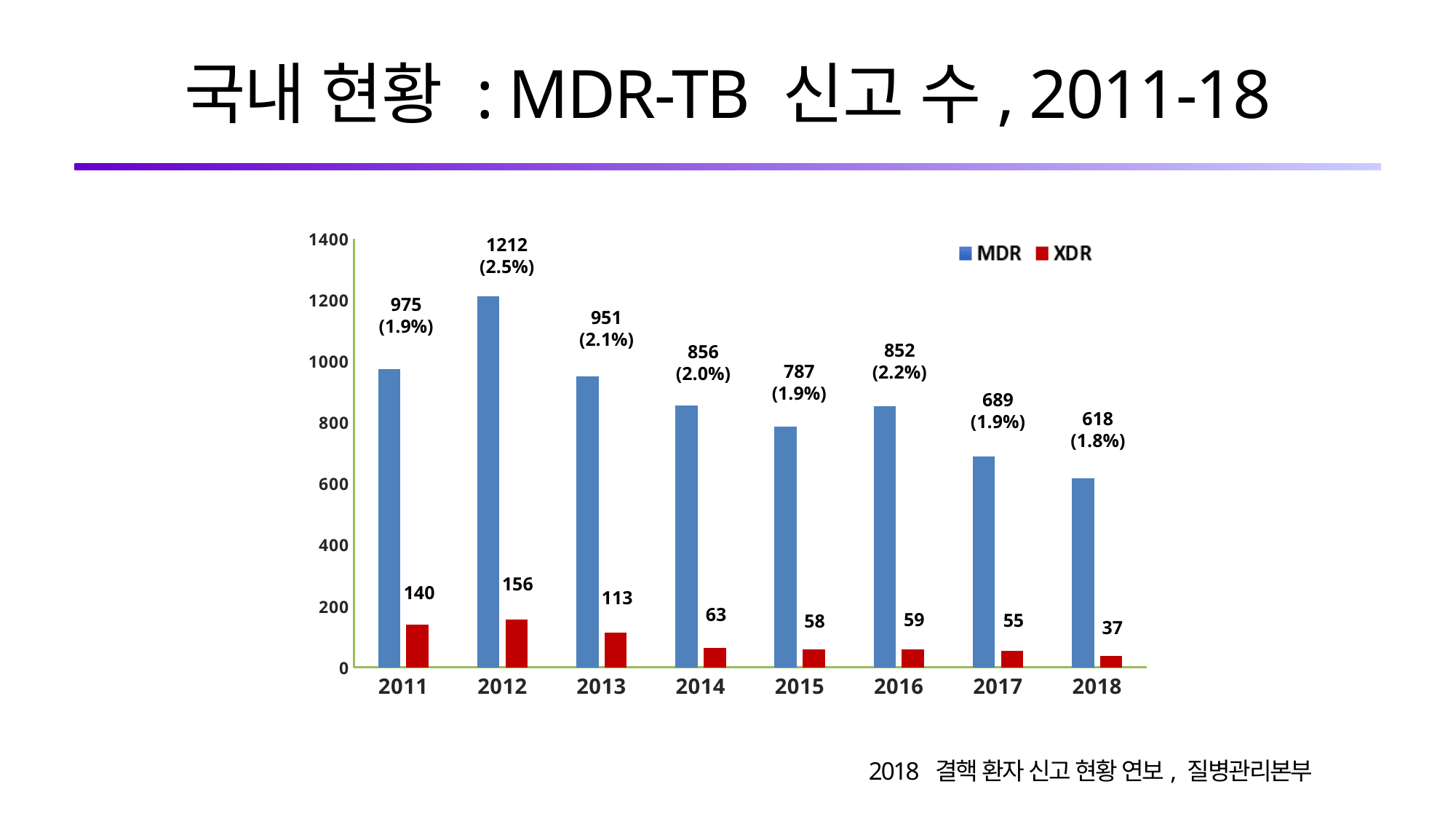
What kind of chart is shown on the slide? bar chart How many series does the legend list? 2 How many years are shown on the x axis? 8 What is the MDR value for 2012? 1212 What is the XDR value for 2018? 37 Which year has the lowest XDR value? 2018 Which is larger, the MDR value for 2014 or the MDR value for 2016? 2014 Which year has the highest MDR value? 2012 What is the difference between the MDR values for 2011 and 2018? 357 Is the MDR value for 2017 greater or less than 800? less What is the difference between the XDR values for 2012 and 2013? 43 What percentage is shown in parentheses for the MDR value in 2016? 2.2%